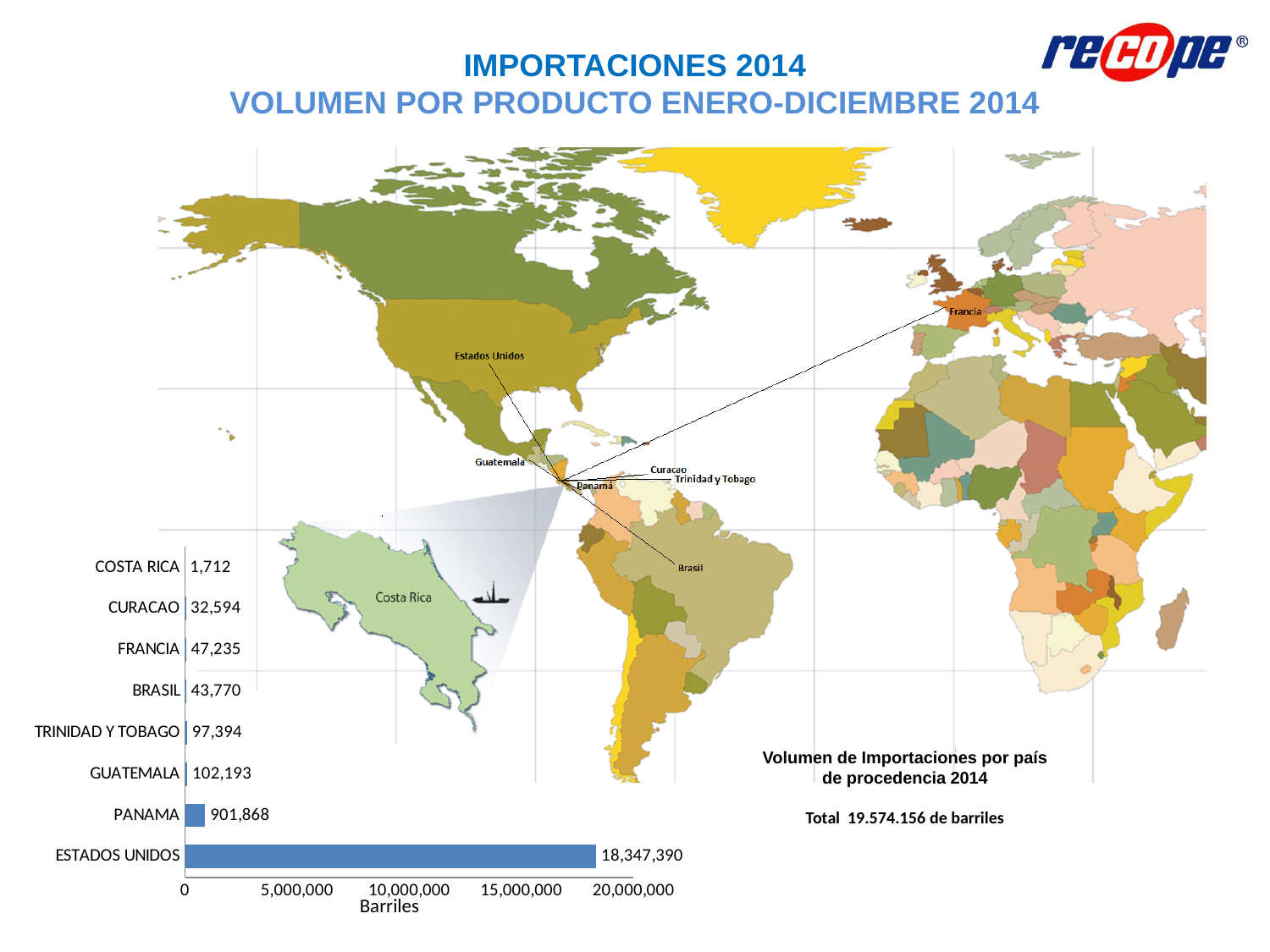
How many countries are shown in the bar chart? 8 What is the import volume for CURACAO? 32,594 What is the import volume for ESTADOS UNIDOS? 18,347,390 What is the import volume for PANAMA? 901,868 What is the import volume for TRINIDAD Y TOBAGO? 97,394 What is the difference between the import volumes of GUATEMALA and TRINIDAD Y TOBAGO? 4,799 Which has a larger import volume, FRANCIA or BRASIL? FRANCIA Which country has the lowest import volume? COSTA RICA What kind of chart is used to show the import volumes by country? bar chart What is the difference between the import volumes of ESTADOS UNIDOS and PANAMA? 17,445,522 What is the label of the horizontal axis of the bar chart? Barriles Which country has the highest import volume? ESTADOS UNIDOS